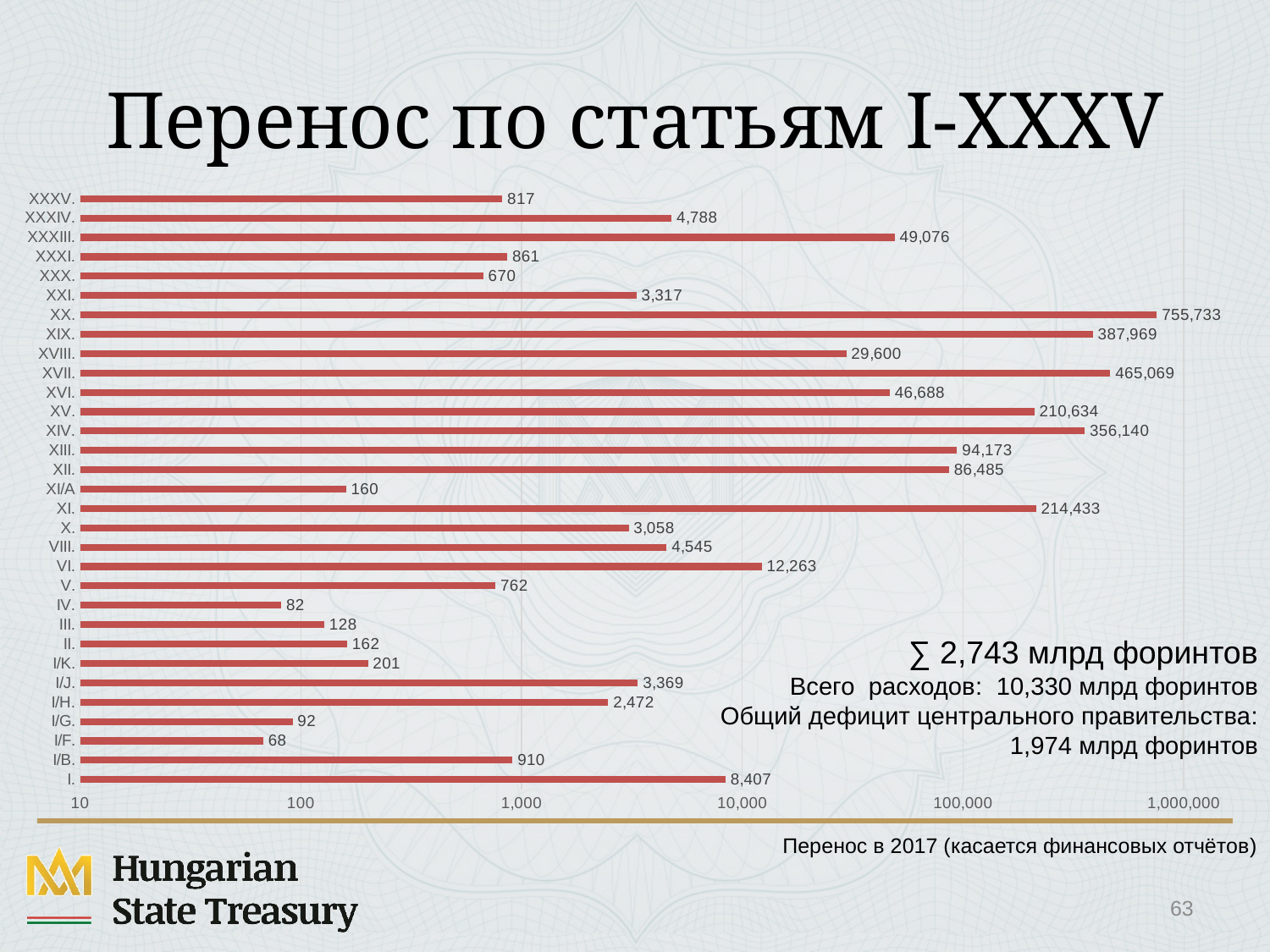
Which is larger, the value for XVII. or the value for XIX.? XVII. What is the value for category XXXIII.? 49,076 What is the value for category I.? 8,407 Is the value for XVIII. greater or less than 10,000? greater What is the value for category XI/A? 160 Which category has the lowest value? I/F. Which category has the highest value? XX. What kind of chart is shown on the slide? bar chart What is the difference between the values for XIII. and XII.? 7,688 How many categories are shown in the chart? 31 What is the value for category XX.? 755,733 What is the difference between the values for XIX. and XIV.? 31,829